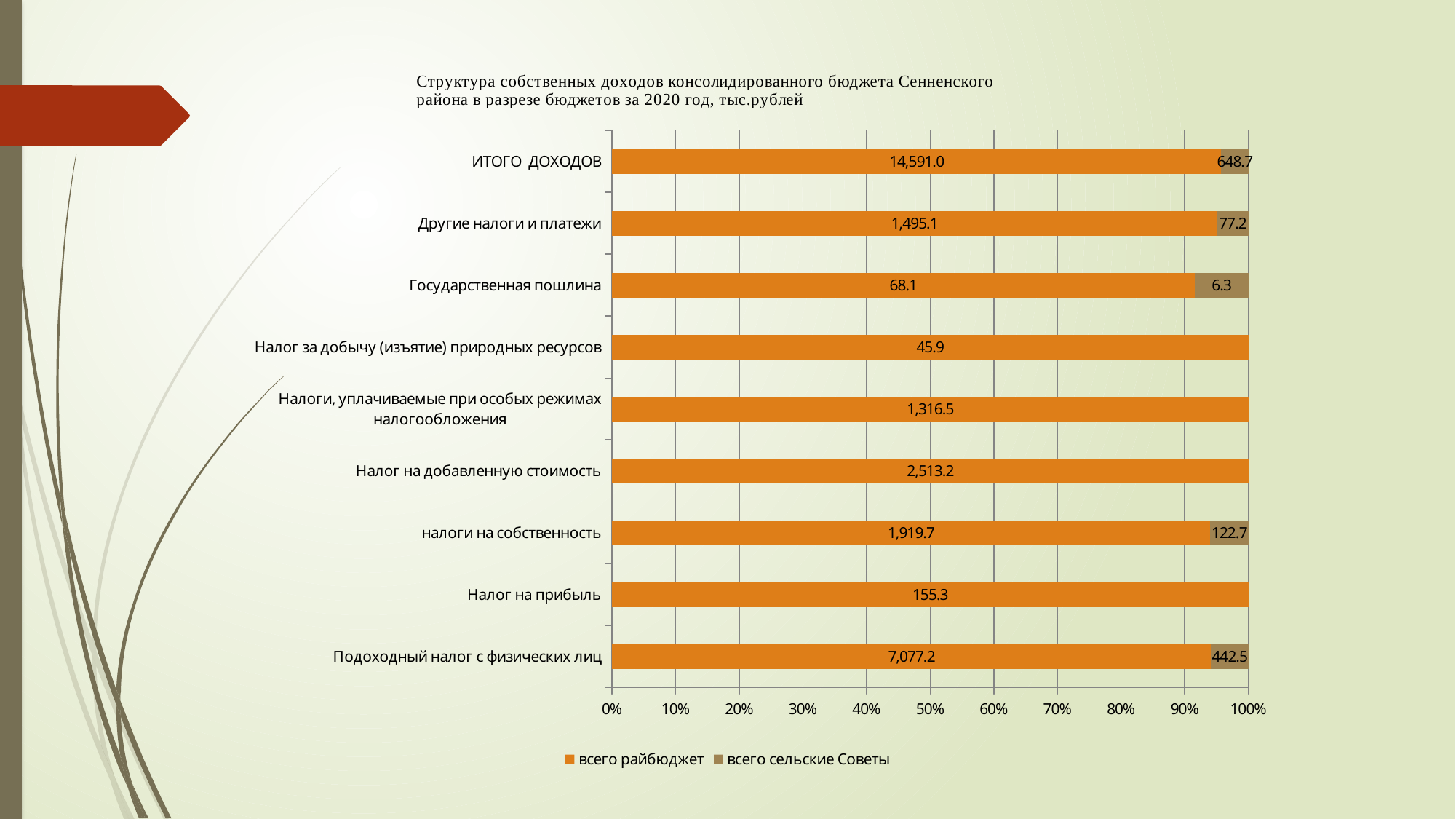
Which category has the lowest value for всего райбюджет? Налог за добычу (изъятие) природных ресурсов What is the value for всего райбюджет for Налог на добавленную стоимость? 2,513.2 What is the value for всего сельские Советы for налоги на собственность? 122.7 Which is larger for всего райбюджет: Налог на добавленную стоимость or налоги на собственность? Налог на добавленную стоимость What is the value for всего райбюджет for Подоходный налог с физических лиц? 7,077.2 What is the value for всего сельские Советы for Государственная пошлина? 6.3 Which category has the highest value for всего райбюджет? ИТОГО ДОХОДОВ How many categories are shown on the chart? 9 What is the difference between the всего сельские Советы values for ИТОГО ДОХОДОВ and Подоходный налог с физических лиц? 206.2 What kind of chart is shown on the slide? bar chart How many series does the legend list? 2